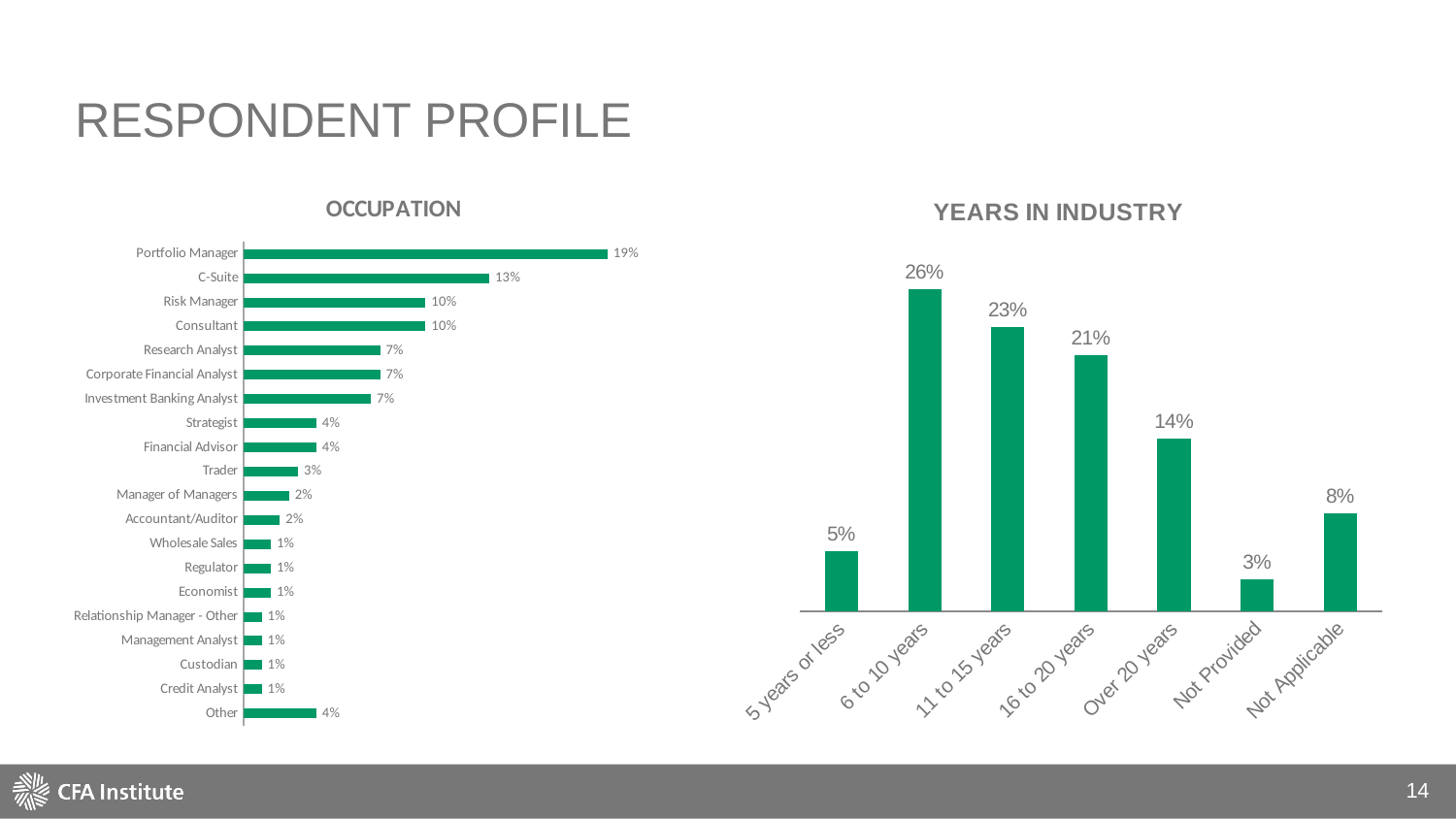
In the Occupation chart, which occupation has the highest percentage? Portfolio Manager In the Years in Industry chart, which is larger: 5 years or less or Not Applicable? Not Applicable In the Occupation chart, what percentage of respondents are Portfolio Managers? 19% In the Years in Industry chart, what is the value for Over 20 years? 14% In the Occupation chart, how many occupation categories are listed? 20 In the Years in Industry chart, which category has the lowest percentage? Not Provided In the Occupation chart, what is the difference between Portfolio Manager and C-Suite? 6% In the Years in Industry chart, which category has the highest percentage? 6 to 10 years In the Occupation chart, what is the value for Trader? 3% In the Years in Industry chart, what is the difference between 6 to 10 years and 11 to 15 years? 3% What type of chart is the Years in Industry chart? Bar chart In the Occupation chart, what is the value for C-Suite? 13%